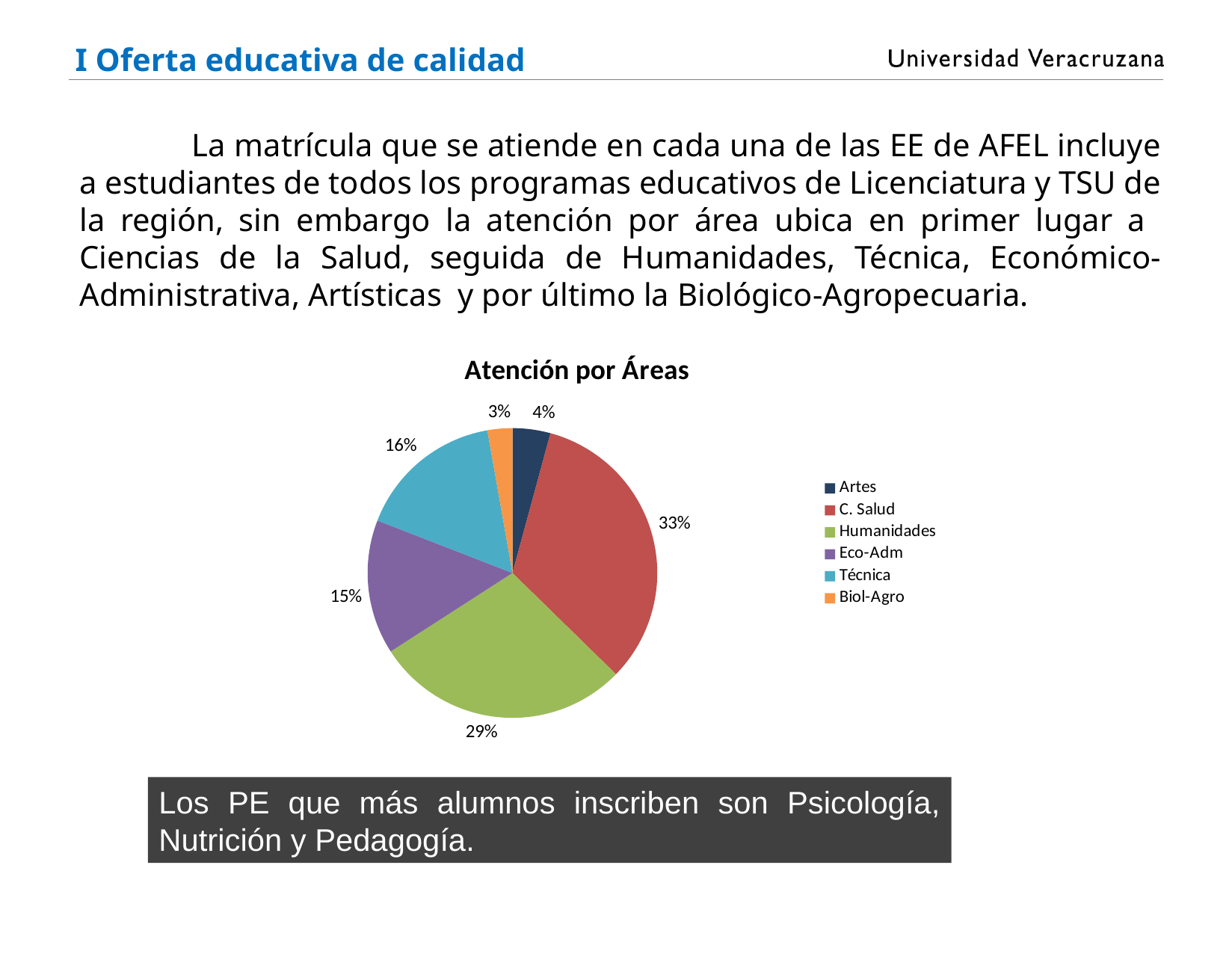
Which area has the largest slice of the pie? C. Salud Which area has the smallest slice of the pie? Biol-Agro What kind of chart is shown on the slide? Pie chart What share of the pie does C. Salud have in the 'Atención por Áreas' chart? 33% What percentage is shown for Biol-Agro? 3% What percentage is shown for Técnica? 16% How many areas does the legend list? 6 What percentage is shown for Humanidades? 29% What is the title of the chart? Atención por Áreas What is the difference in percentage points between C. Salud and Humanidades? 4 Which is larger, the share for Técnica or the share for Eco-Adm? Técnica What percentage is shown for Eco-Adm? 15%